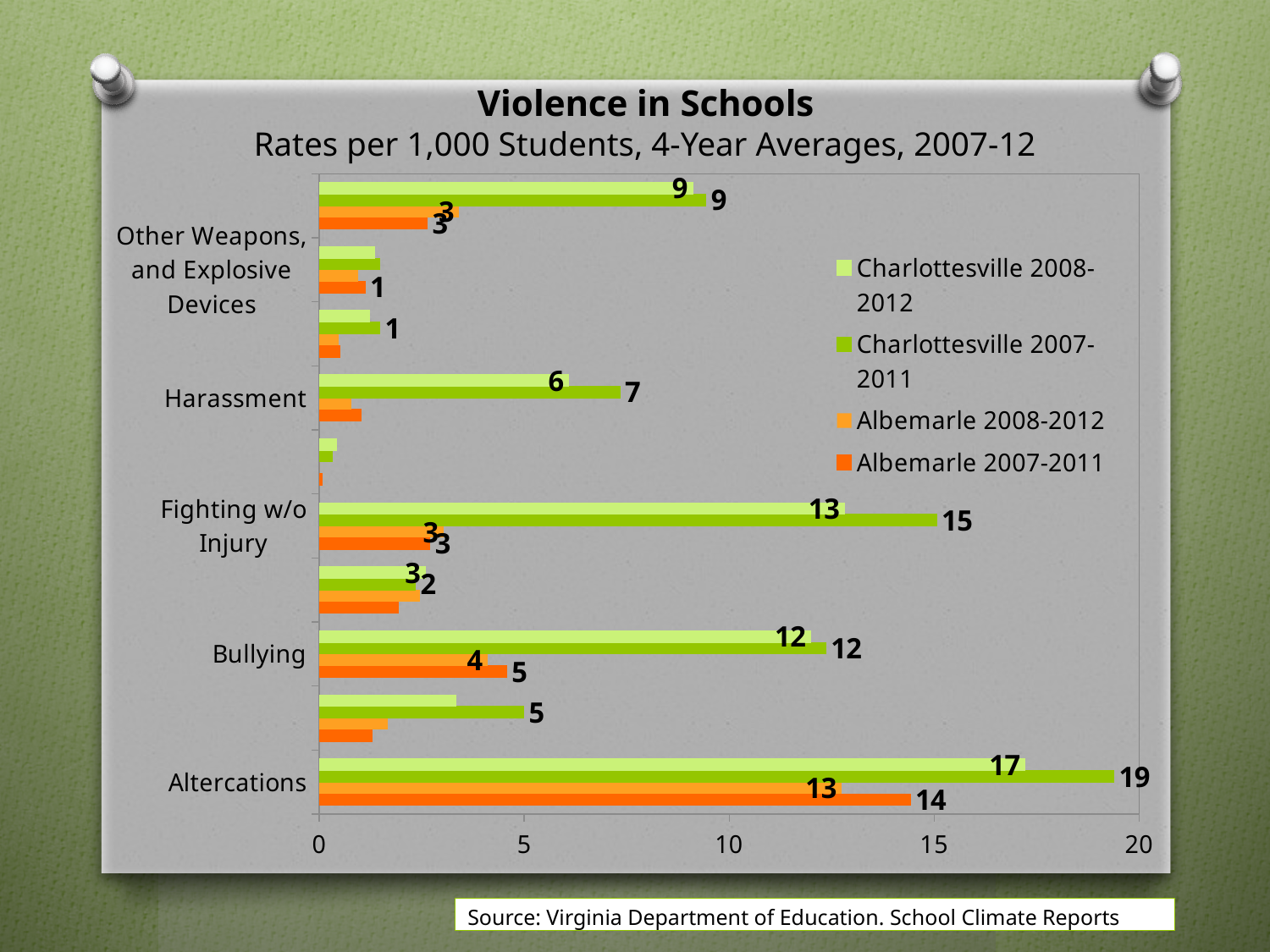
What is the Fighting w/o Injury rate for Charlottesville 2008-2012? 13 What is the main title of the chart? Violence in Schools For Altercations, how much higher is the Charlottesville 2007-2011 rate than the Albemarle 2007-2011 rate? 5 What is the Altercations rate for Charlottesville 2007-2011? 19 What is the Bullying rate for Albemarle 2007-2011? 5 Which labeled category has the highest rate for Charlottesville 2007-2011? Altercations What is the Altercations rate for Albemarle 2008-2012? 13 How many series does the legend list? 4 Is the Harassment rate for Albemarle 2008-2012 greater or less than 5? less What is the Harassment rate for Charlottesville 2007-2011? 7 What kind of chart is shown on the slide? bar chart For Fighting w/o Injury, which is larger: the Charlottesville 2007-2011 rate or the Albemarle 2007-2011 rate? Charlottesville 2007-2011